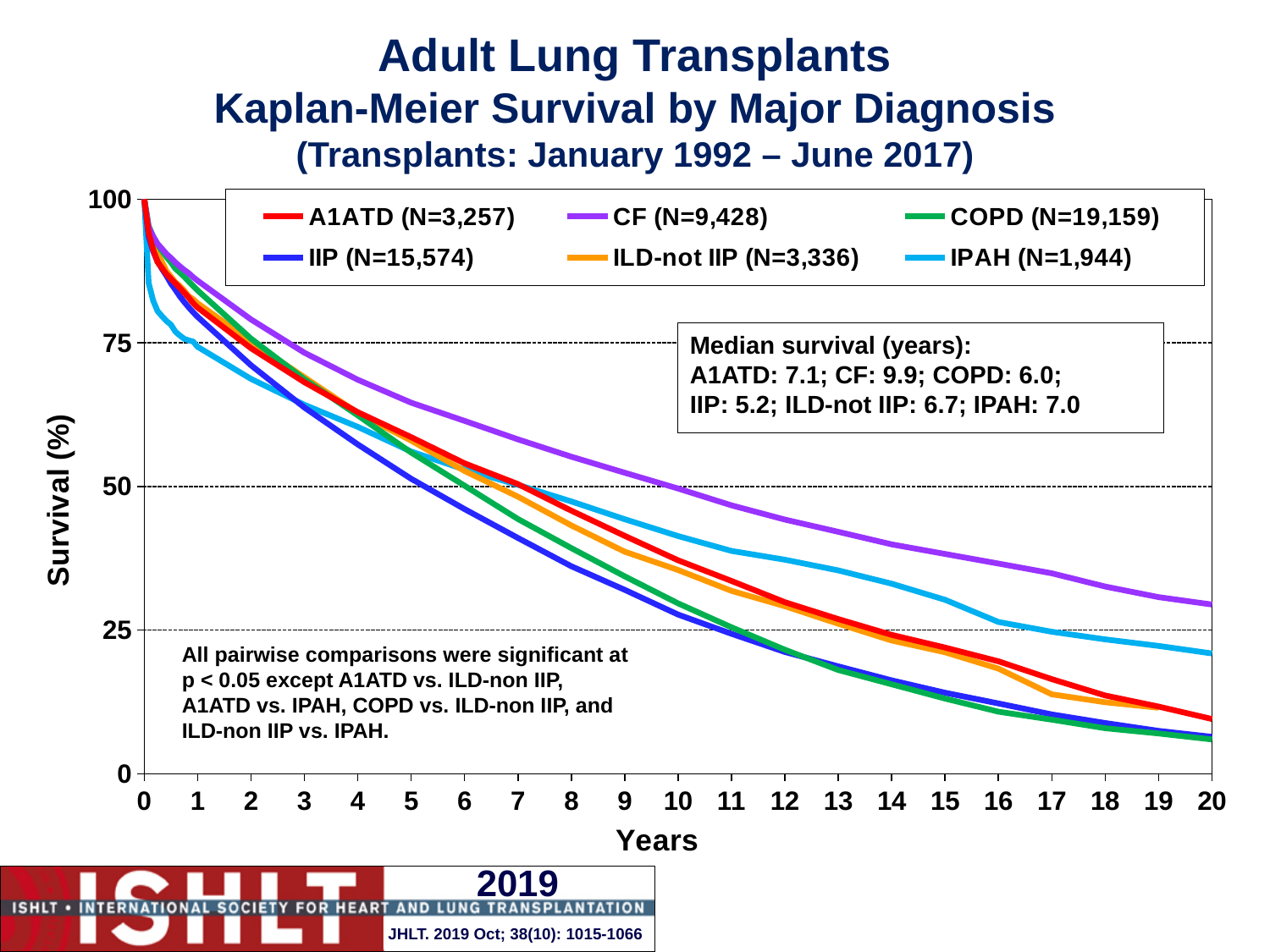
Is the survival for IIP at 10 years greater or less than 50%? less Which has the larger median survival, A1ATD or IPAH? A1ATD Do the survival curves rise or fall as years increase? fall What is the N for COPD shown in the legend? 19,159 Is the survival for CF at 20 years greater or less than 25%? greater What is the median survival in years for IIP? 5.2 What is the difference in median survival (years) between CF and IIP? 4.7 What is the median survival in years for CF? 9.9 What kind of chart is shown on the slide? line chart Which diagnosis group has the highest median survival? CF How many diagnosis groups does the legend list? 6 Which diagnosis group has the lowest median survival? IIP